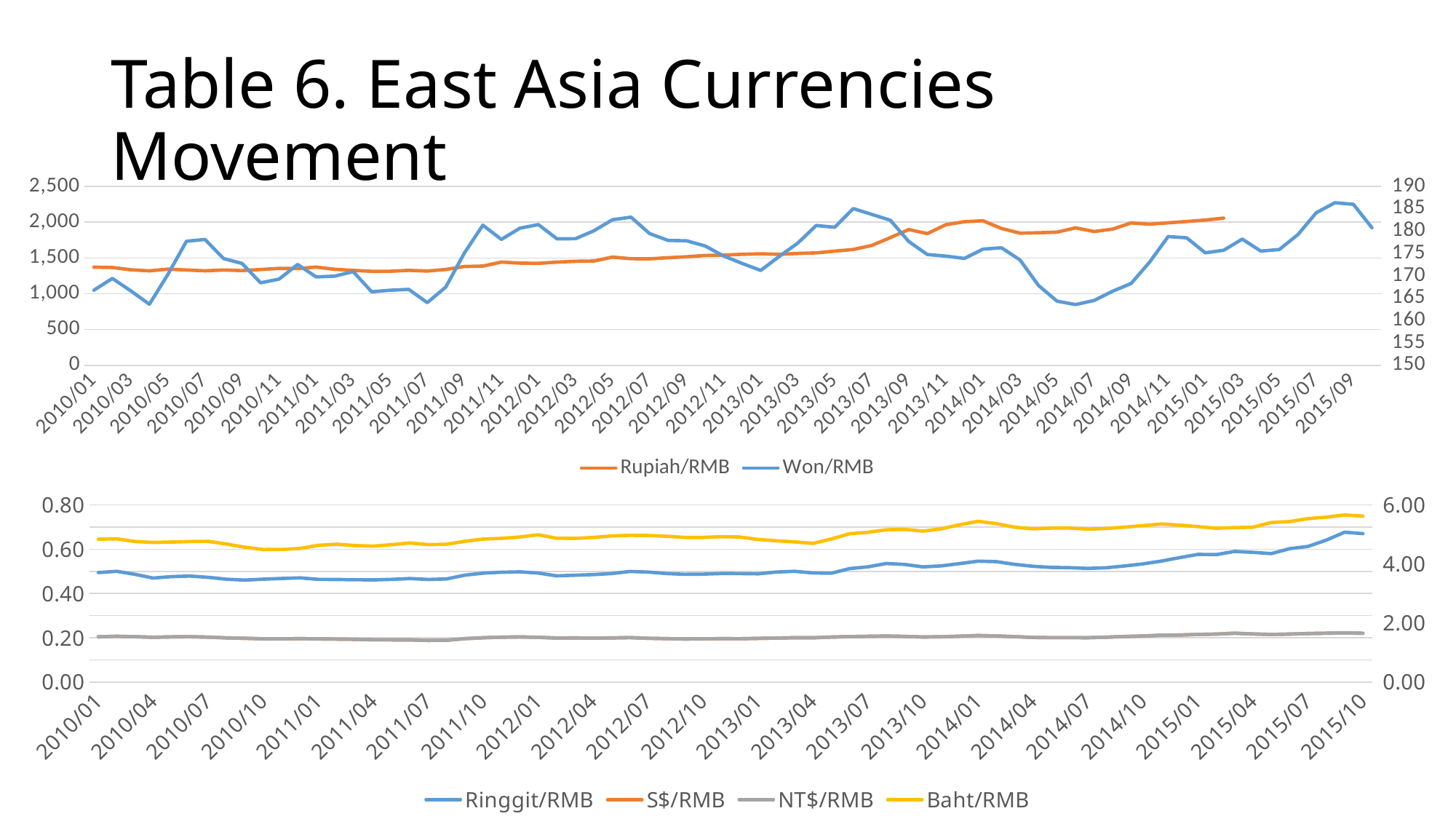
What is the title of the slide? Table 6. East Asia Currencies Movement In the top chart, is the Won/RMB value at 2015/08 greater or less than 180 on the right axis? greater In the top chart, is the Rupiah/RMB value at 2010/01 greater or less than 1,500 on the left axis? less In the bottom chart, does the Ringgit/RMB line generally rise or fall from 2010/01 to 2015/10? rise How many series does the legend of the top chart list? 2 How many series does the legend of the bottom chart list? 4 In the top chart, is the Rupiah/RMB value at 2010/01 greater or less than 1,000 on the left axis? greater In the bottom chart, which series is drawn as the yellow line? Baht/RMB In the top chart, does the Rupiah/RMB line generally rise or fall from 2010/01 to 2015/03? rise In the bottom chart, does the Baht/RMB line generally rise or fall from 2010/01 to 2015/10? rise What kind of chart is the top chart on the slide? line chart